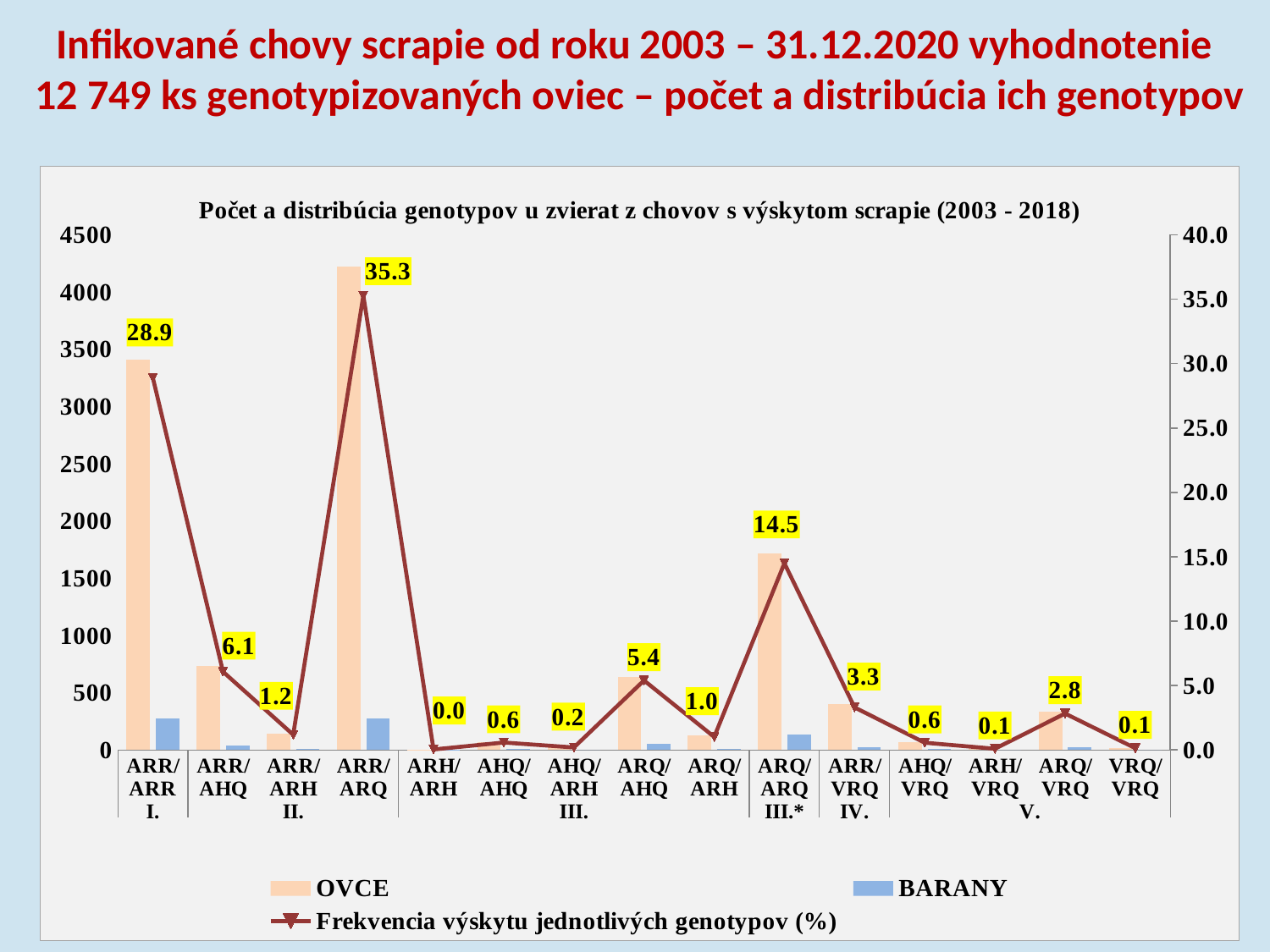
How many series does the legend list? 3 What is the frequency (%) value shown for the ARR/ARR genotype? 28.9 Is the OVCE bar for ARQ/ARQ greater or less than 1500? greater What is the difference between the frequency (%) values for ARR/ARQ and ARR/ARR? 6.4 Is the OVCE bar for ARR/ARQ greater or less than 4000? greater Which genotype has the highest frequency (%) value on the line? ARR/ARQ What is the frequency (%) value shown for the ARR/ARQ genotype? 35.3 What is the frequency (%) value shown for the ARQ/AHQ genotype? 5.4 What is the frequency (%) value shown for the ARQ/ARQ genotype? 14.5 Which genotype has the lowest frequency (%) value on the line? ARH/ARH Which has a higher frequency (%) value: ARR/AHQ or ARQ/AHQ? ARR/AHQ How many genotype categories are shown on the x axis? 15